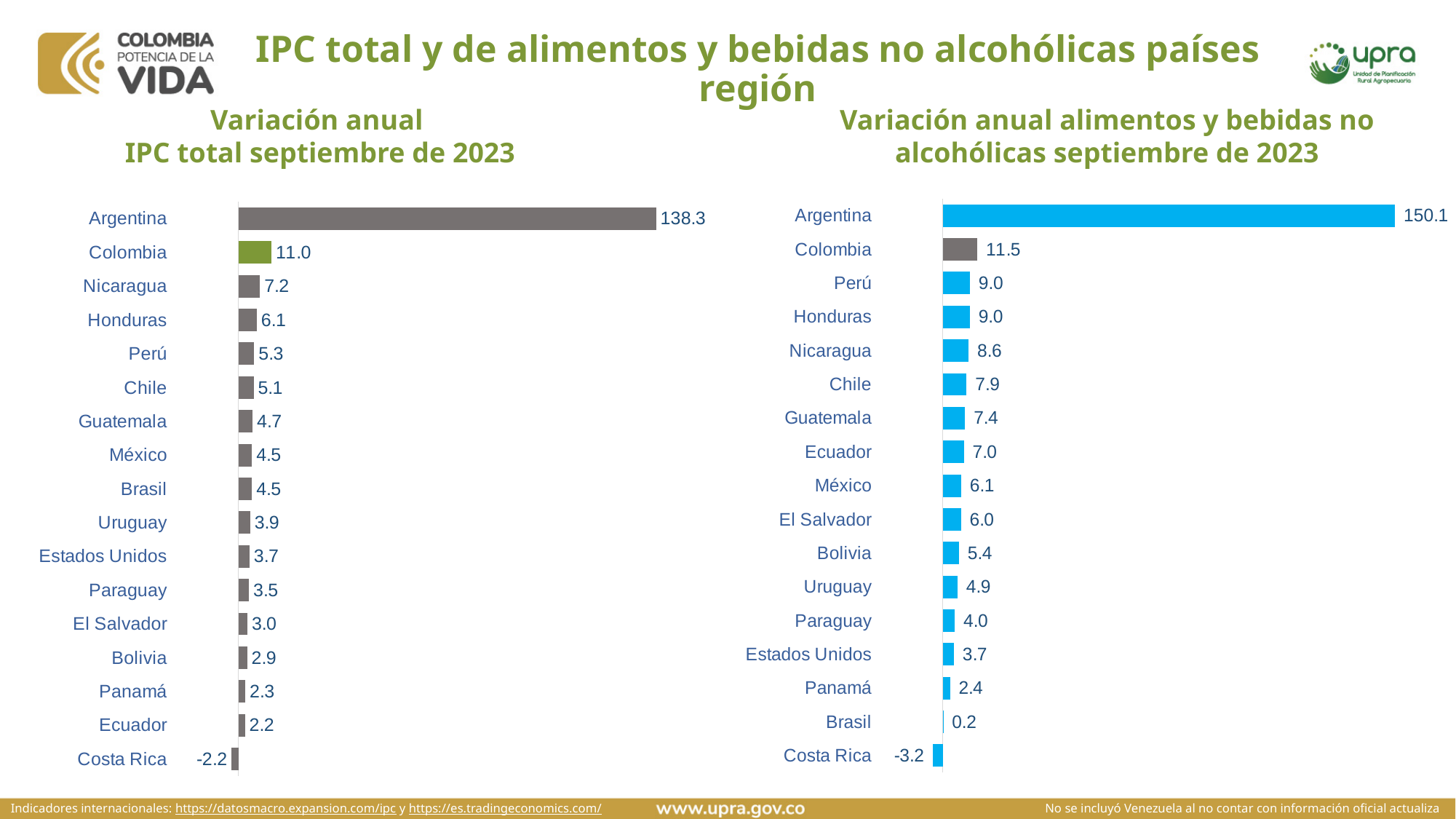
In the left chart (Variación anual IPC total septiembre de 2023), which country's bar is coloured green instead of grey? Colombia How many countries are shown in the right chart (Variación anual alimentos y bebidas no alcohólicas septiembre de 2023)? 17 In the right chart (Variación anual alimentos y bebidas no alcohólicas septiembre de 2023), what is the value for Argentina? 150.1 In the right chart (Variación anual alimentos y bebidas no alcohólicas septiembre de 2023), which country has the highest value? Argentina In the left chart (Variación anual IPC total septiembre de 2023), what is the value for Colombia? 11.0 What kind of chart is the left chart (Variación anual IPC total septiembre de 2023)? Bar chart In the right chart (Variación anual alimentos y bebidas no alcohólicas septiembre de 2023), what is the value for Brasil? 0.2 In the left chart (Variación anual IPC total septiembre de 2023), which country has the lowest value? Costa Rica How many countries are shown in the left chart (Variación anual IPC total septiembre de 2023)? 17 In the right chart (Variación anual alimentos y bebidas no alcohólicas septiembre de 2023), which is larger, the value for Chile or the value for Ecuador? Chile In the left chart (Variación anual IPC total septiembre de 2023), what is the difference between the values for Argentina and Colombia? 127.3 In the left chart (Variación anual IPC total septiembre de 2023), what is the value for Nicaragua? 7.2